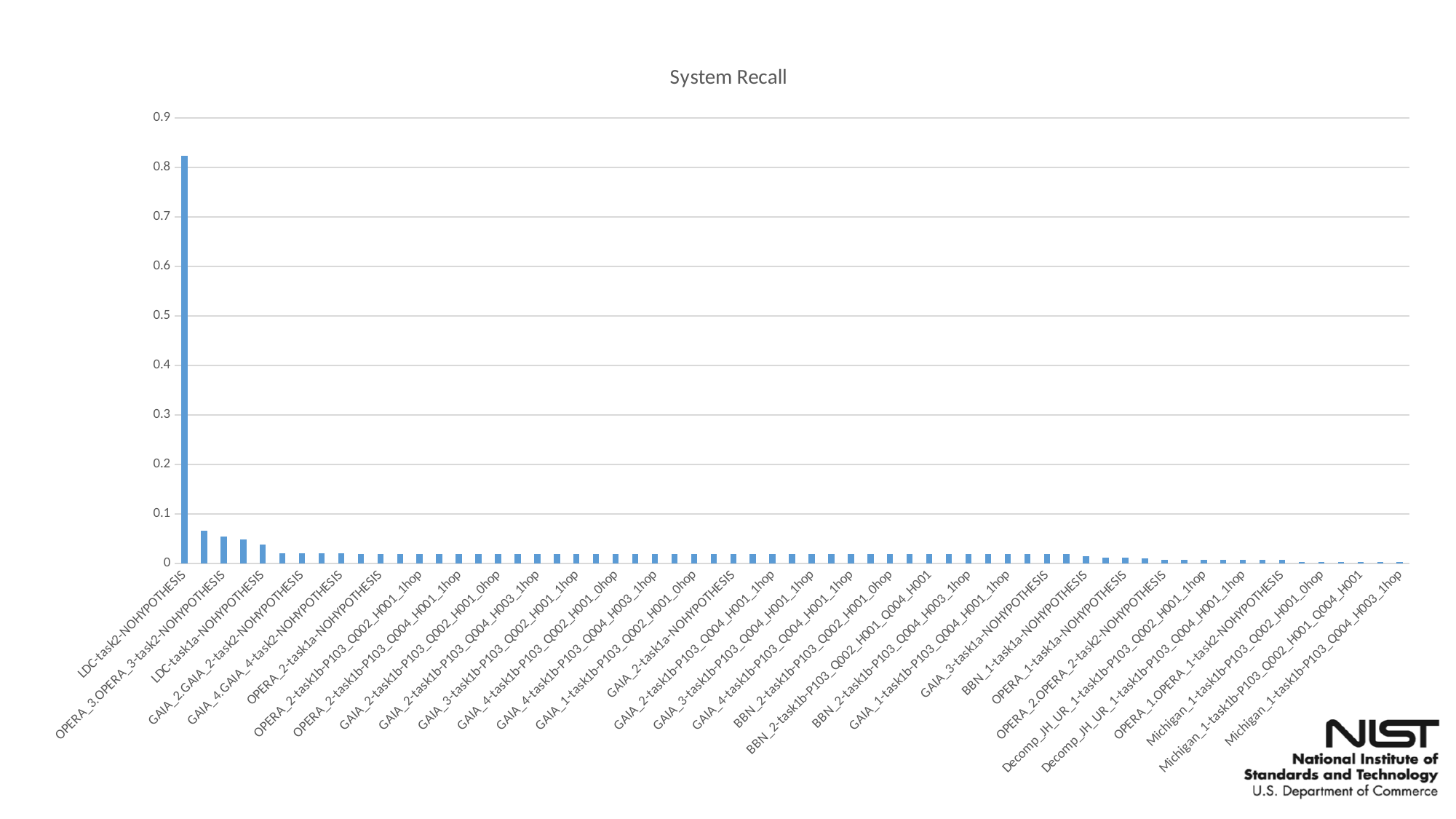
Which category has the highest System Recall? LDC-task2-NOHYPOTHESIS Is the value for GAIA_2.GAIA_2-task2-NOHYPOTHESIS greater or less than 0.1? less Is the value for LDC-task2-NOHYPOTHESIS greater or less than 0.5? greater Which is larger, the value for OPERA_3.OPERA_3-task2-NOHYPOTHESIS or the value for Michigan_1-task1b-P103_Q004_H003_1hop? OPERA_3.OPERA_3-task2-NOHYPOTHESIS Do the values generally rise or fall from left to right along the x axis? fall What kind of chart is shown on the slide? bar chart Which is larger, the value for LDC-task2-NOHYPOTHESIS or the value for LDC-task1a-NOHYPOTHESIS? LDC-task2-NOHYPOTHESIS Is the value for LDC-task2-NOHYPOTHESIS greater or less than 0.7? greater What is the title of the chart? System Recall What is the highest value shown on the vertical axis? 0.9